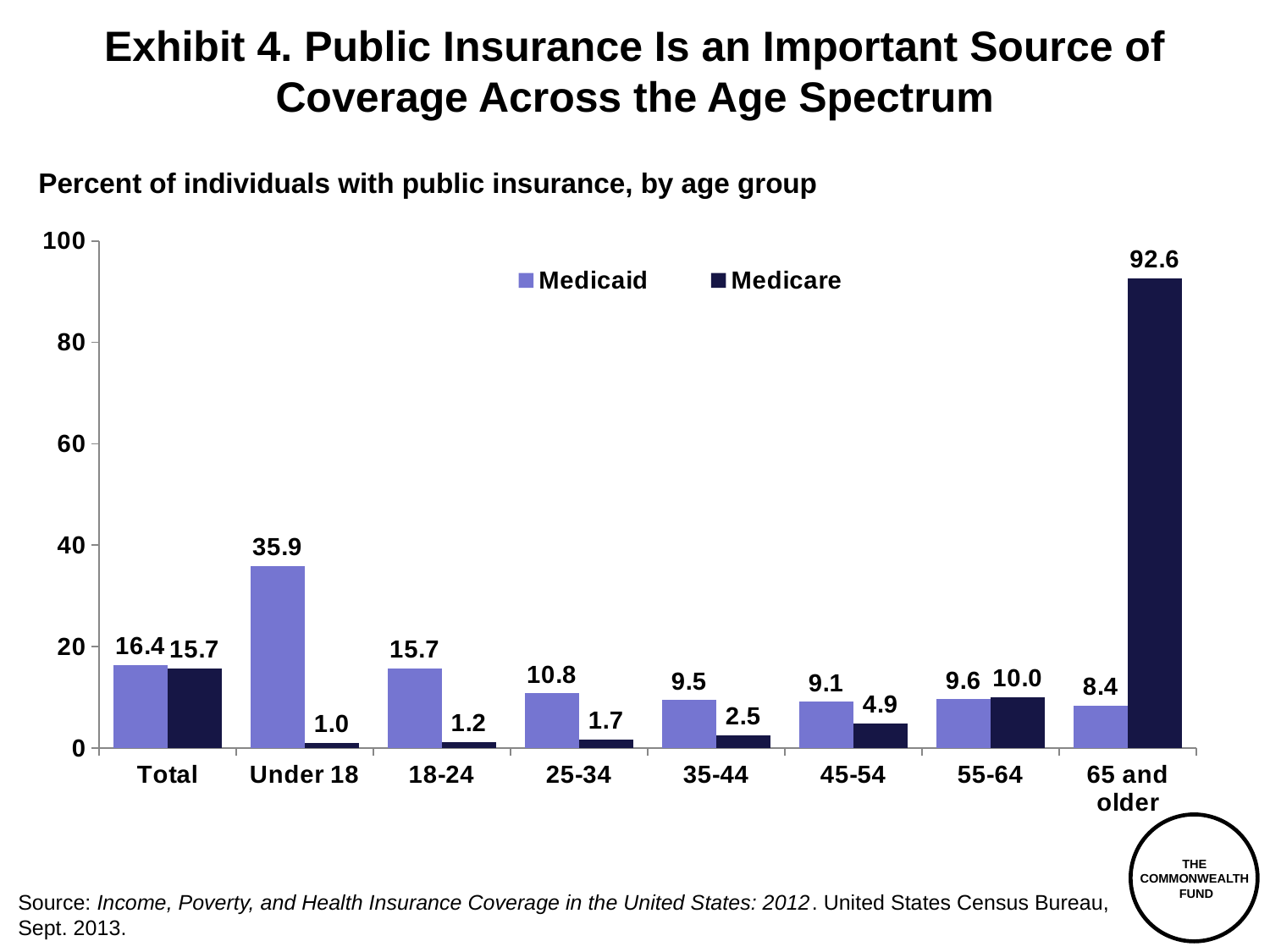
What kind of chart is shown on the slide? bar chart What is the Medicaid value for the Under 18 age group? 35.9 What is the difference between the Medicare and Medicaid values for the 65 and older age group? 84.2 Which age group has the lowest Medicare value? Under 18 What is the Medicare value for the 65 and older age group? 92.6 How many series does the legend list? 2 Which age group has the highest Medicaid value? Under 18 What are the two series named in the legend? Medicaid and Medicare What is the Medicare value for the 45-54 age group? 4.9 How many age group categories are shown on the x axis? 8 Which is larger for the 55-64 age group, the Medicaid value or the Medicare value? Medicare Is the Medicare value for the 65 and older age group greater or less than 80? greater